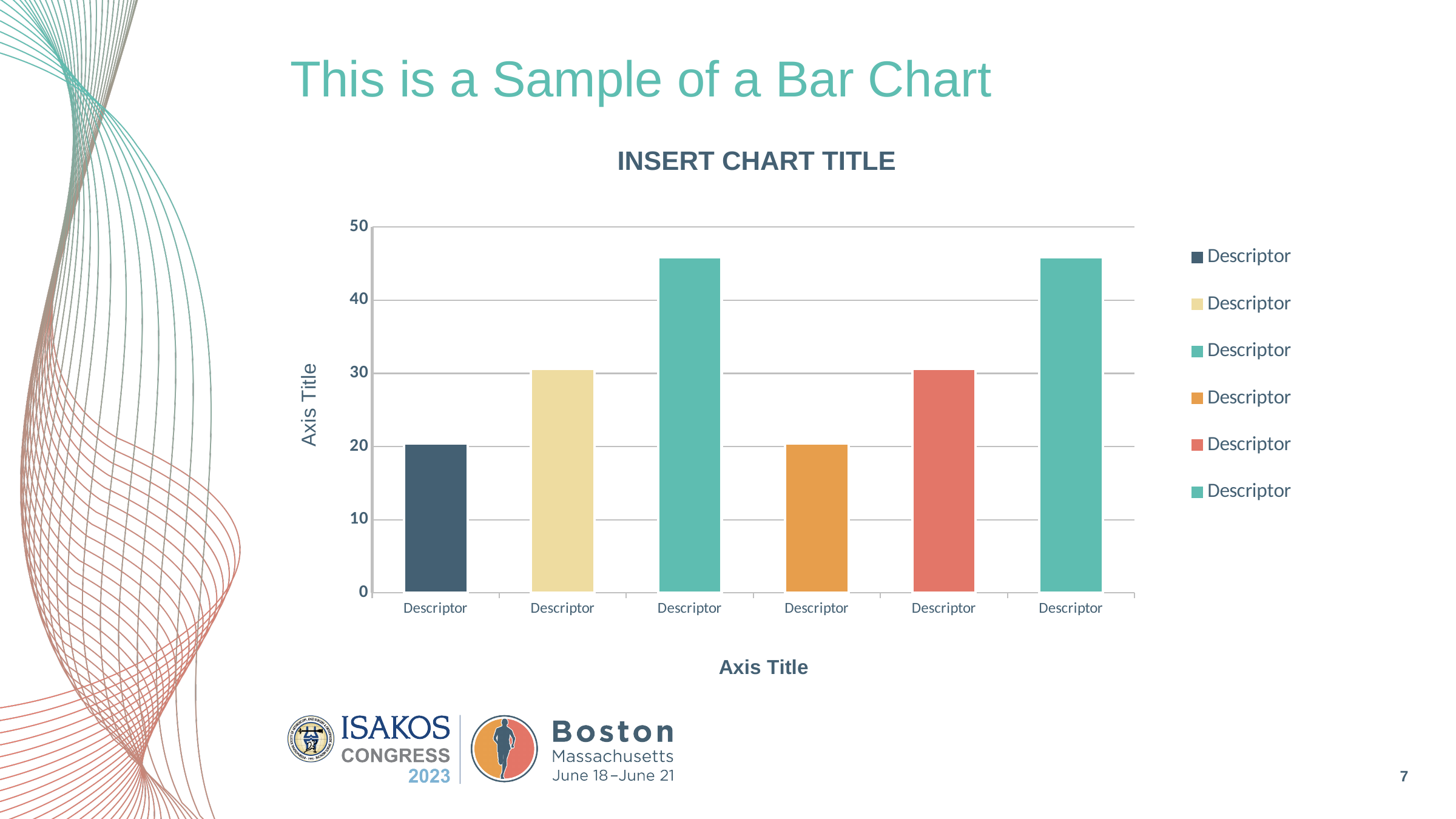
Is the value of the second bar from the left (yellow) greater or less than 40? less Which is larger, the first bar from the left or the second bar from the left? the second bar Is the value of the sixth (rightmost) bar greater or less than 50? less Which is larger, the third bar from the left or the fourth bar from the left? the third bar How many bars are plotted in the chart? 6 What kind of chart is shown on the slide? bar chart Is the value of the fourth bar from the left (orange) greater or less than 10? greater What is the title of the chart? INSERT CHART TITLE What is the label on the vertical axis of the chart? Axis Title How many entries does the chart's legend list? 6